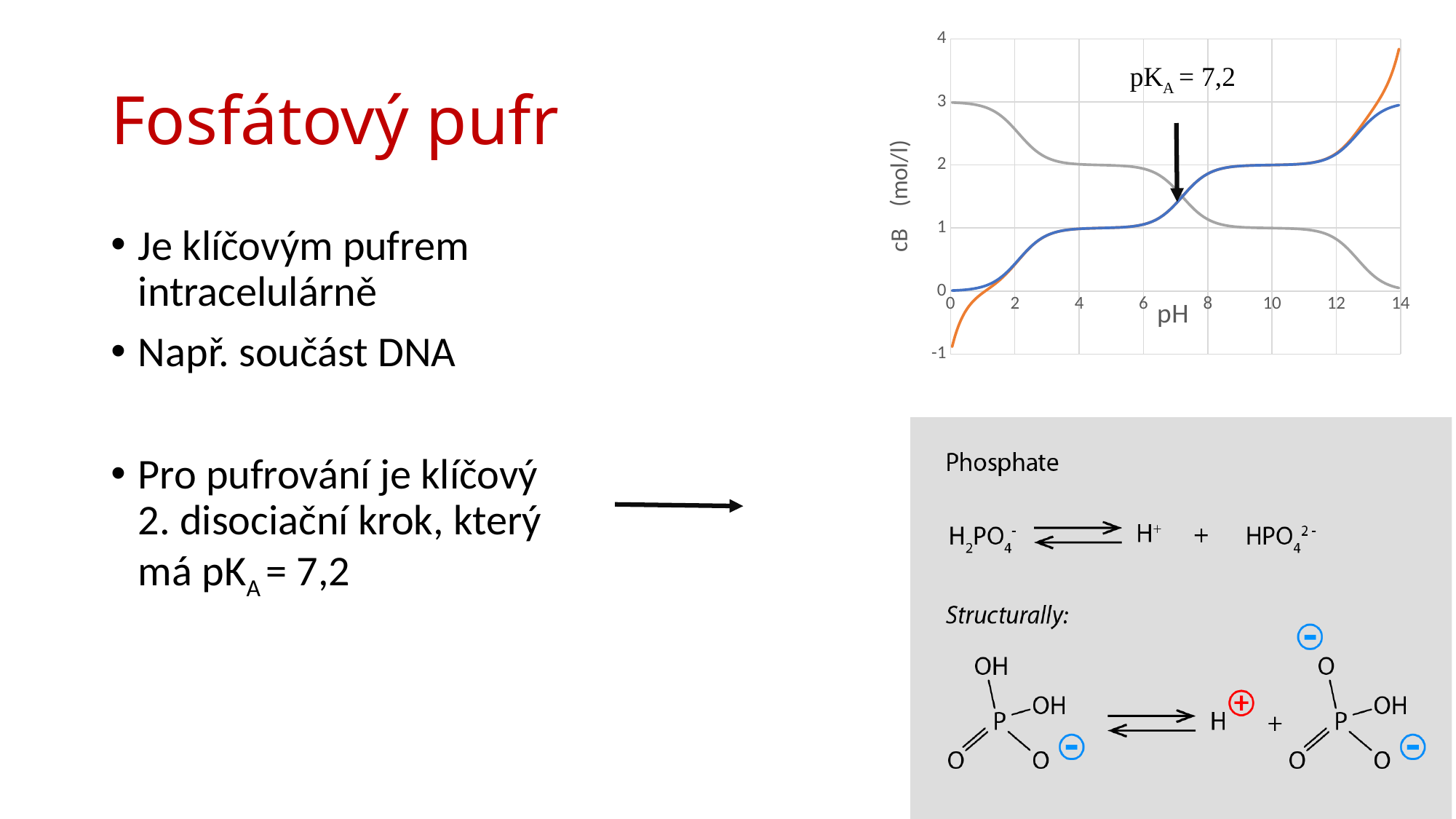
Is the value of the blue line at pH 14 greater or less than 2? greater At pH 0, which line has the higher value, the grey line or the blue line? grey line What pKA value does the annotation on the chart point to? pKA = 7,2 At pH 14, which line has the higher value, the orange line or the blue line? orange line What kind of chart is shown on the slide? line chart Is the value of the orange line at pH 0 greater or less than 0? less What is the label of the x axis of the chart? pH Does the grey line rise or fall as pH increases from 0 to 14? fall What is the label of the y axis of the chart? cB (mol/l) Does the blue line rise or fall as pH increases from 0 to 14? rise Is the value of the orange line at pH 14 greater or less than 3? greater How many lines are plotted on the chart? 3